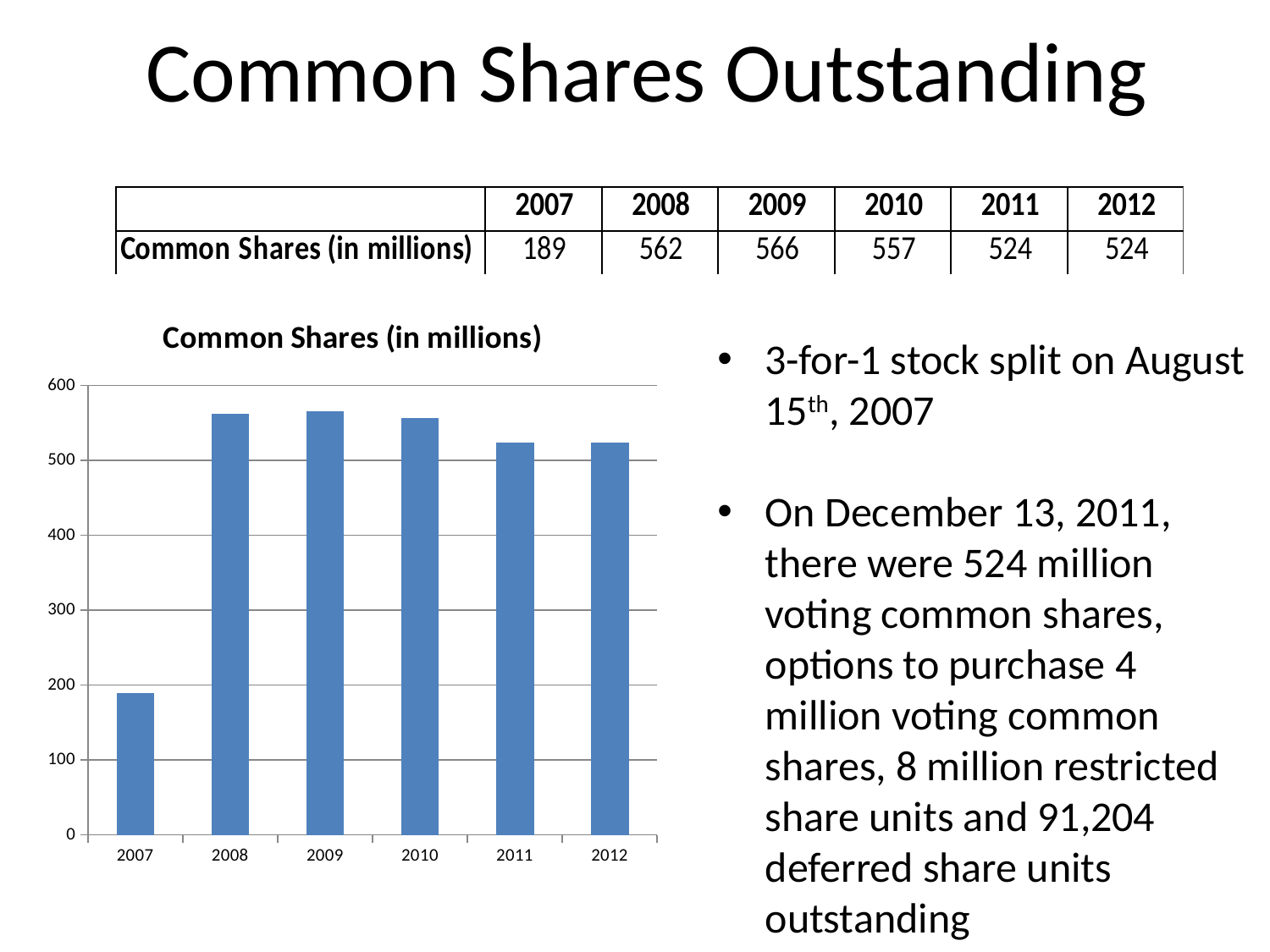
Which year has the lowest value in the Common Shares (in millions) chart? 2007 What is the title of the chart on the slide? Common Shares (in millions) What kind of chart is the Common Shares (in millions) chart? bar chart Which is larger in the Common Shares (in millions) chart, the value for 2008 or the value for 2010? 2008 Is the value for 2007 in the Common Shares (in millions) chart greater or less than 200? less What is the value for 2007 in the Common Shares (in millions) chart? 189 What is the difference between the 2010 and 2011 values in the Common Shares (in millions) chart? 33 What is the value for 2011 in the Common Shares (in millions) chart? 524 What is the value for 2009 in the Common Shares (in millions) chart? 566 How many years are shown on the x axis of the Common Shares (in millions) chart? 6 Which year has the highest value in the Common Shares (in millions) chart? 2009 What is the difference between the 2008 and 2007 values in the Common Shares (in millions) chart? 373